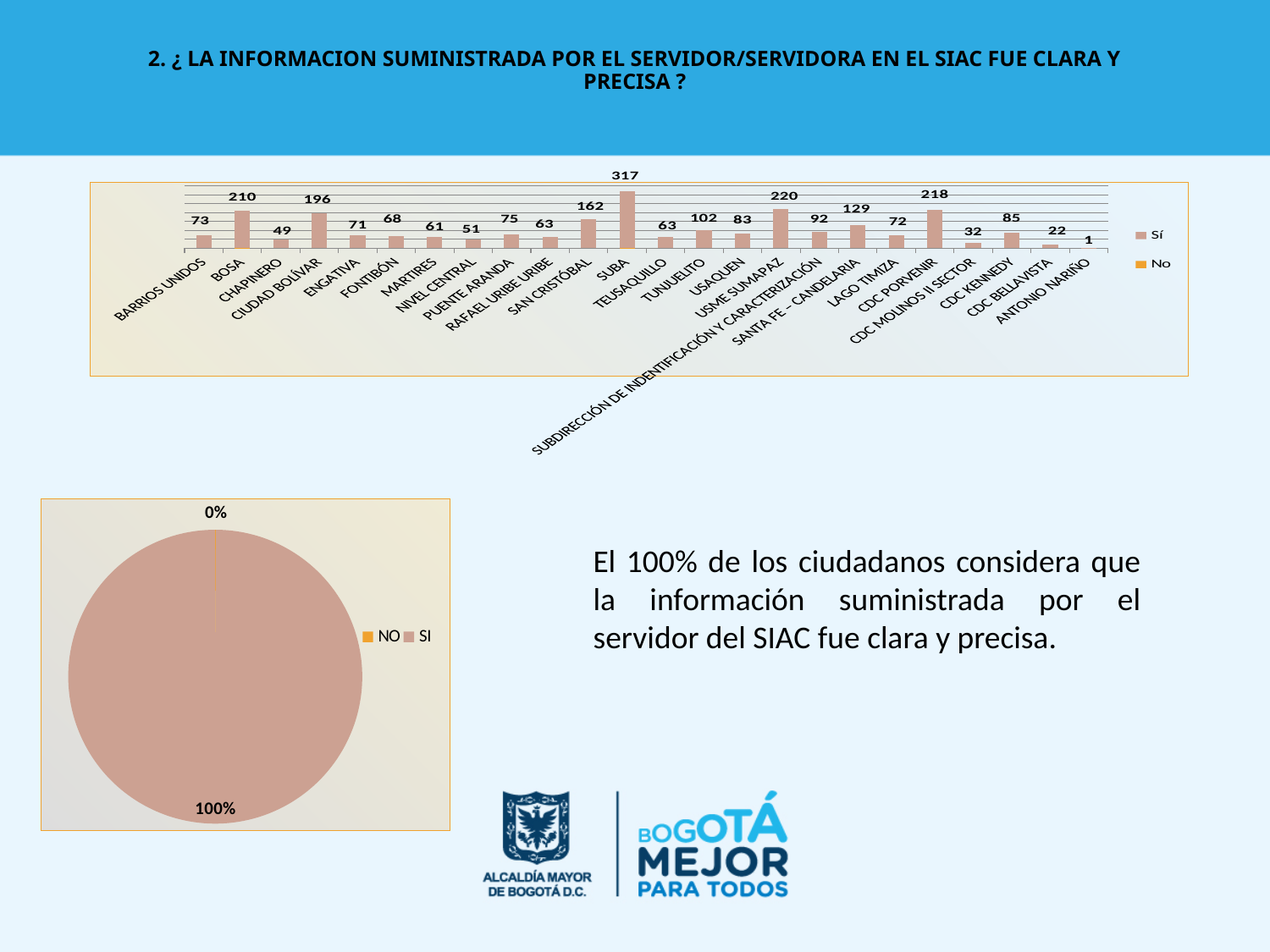
How many categories are shown in the bar chart at the top of the slide? 24 In the bar chart at the top of the slide, what is the value for SUBA? 317 In the bar chart at the top of the slide, which category has the highest value? SUBA In the bar chart at the top of the slide, what is the difference between the values for USME SUMAPAZ and CDC PORVENIR? 2 What kind of chart is the chart at the bottom left of the slide? Pie chart In the pie chart at the bottom left of the slide, what share does NO have? 0% In the pie chart at the bottom left of the slide, what share does SI have? 100% In the bar chart at the top of the slide, which category has the lowest value? ANTONIO NARIÑO In the bar chart at the top of the slide, what is the value for CIUDAD BOLÍVAR? 196 How many series does the legend of the bar chart at the top of the slide list? 2 In the bar chart at the top of the slide, what is the value for CDC KENNEDY? 85 In the bar chart at the top of the slide, which is larger, the value for BOSA or the value for SAN CRISTÓBAL? BOSA